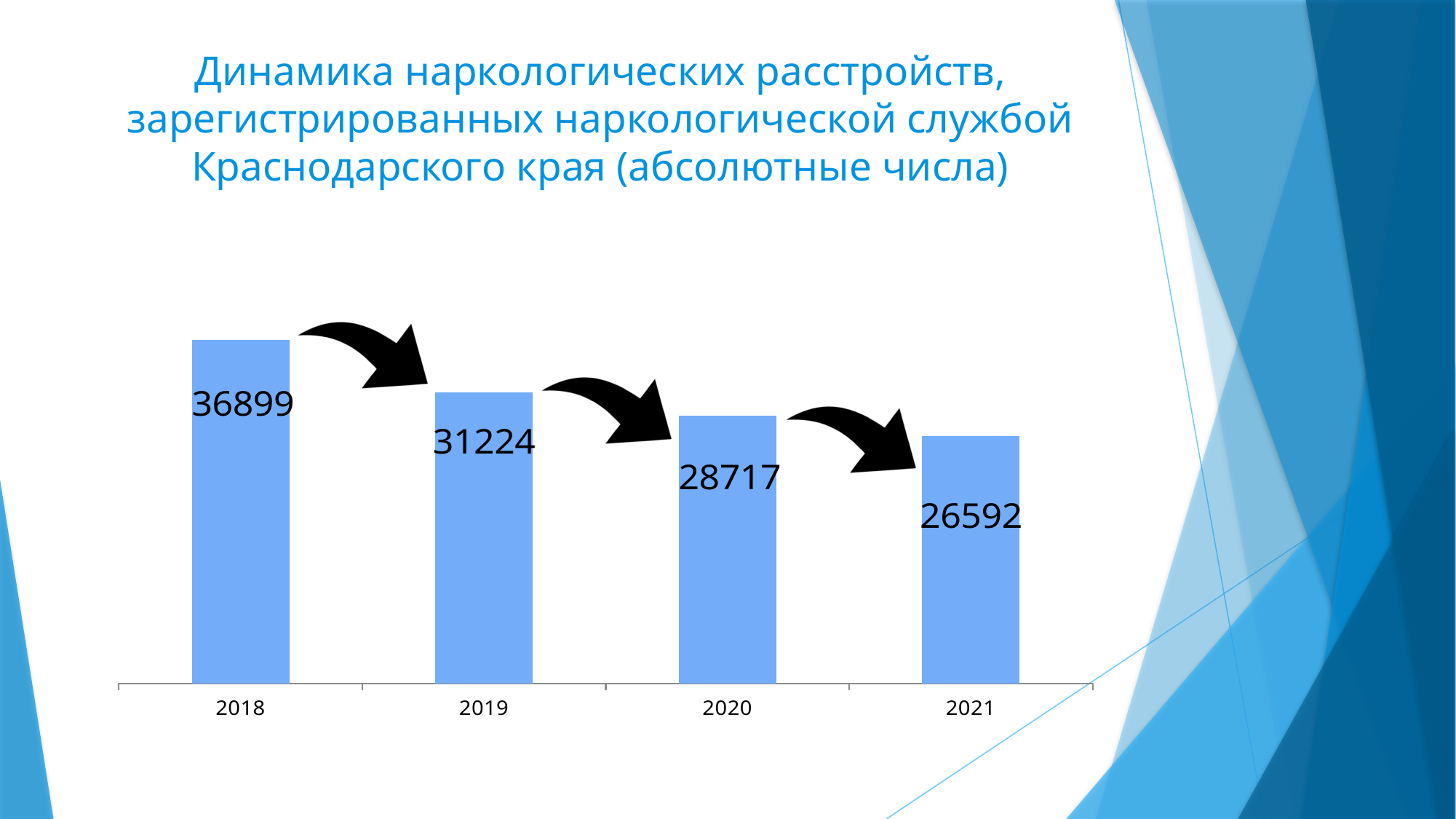
What is the value for 2019? 31224 What is the difference between the values for 2020 and 2021? 2125 What is the value for 2018? 36899 What is the difference between the values for 2018 and 2019? 5675 What is the value for 2020? 28717 How many years are shown on the x axis? 4 Which year has the lowest value? 2021 Which is larger, the value for 2019 or the value for 2020? 2019 What kind of chart is shown on the slide? bar chart What is the value for 2021? 26592 Do the values rise or fall from 2018 to 2021? fall Which year has the highest value? 2018